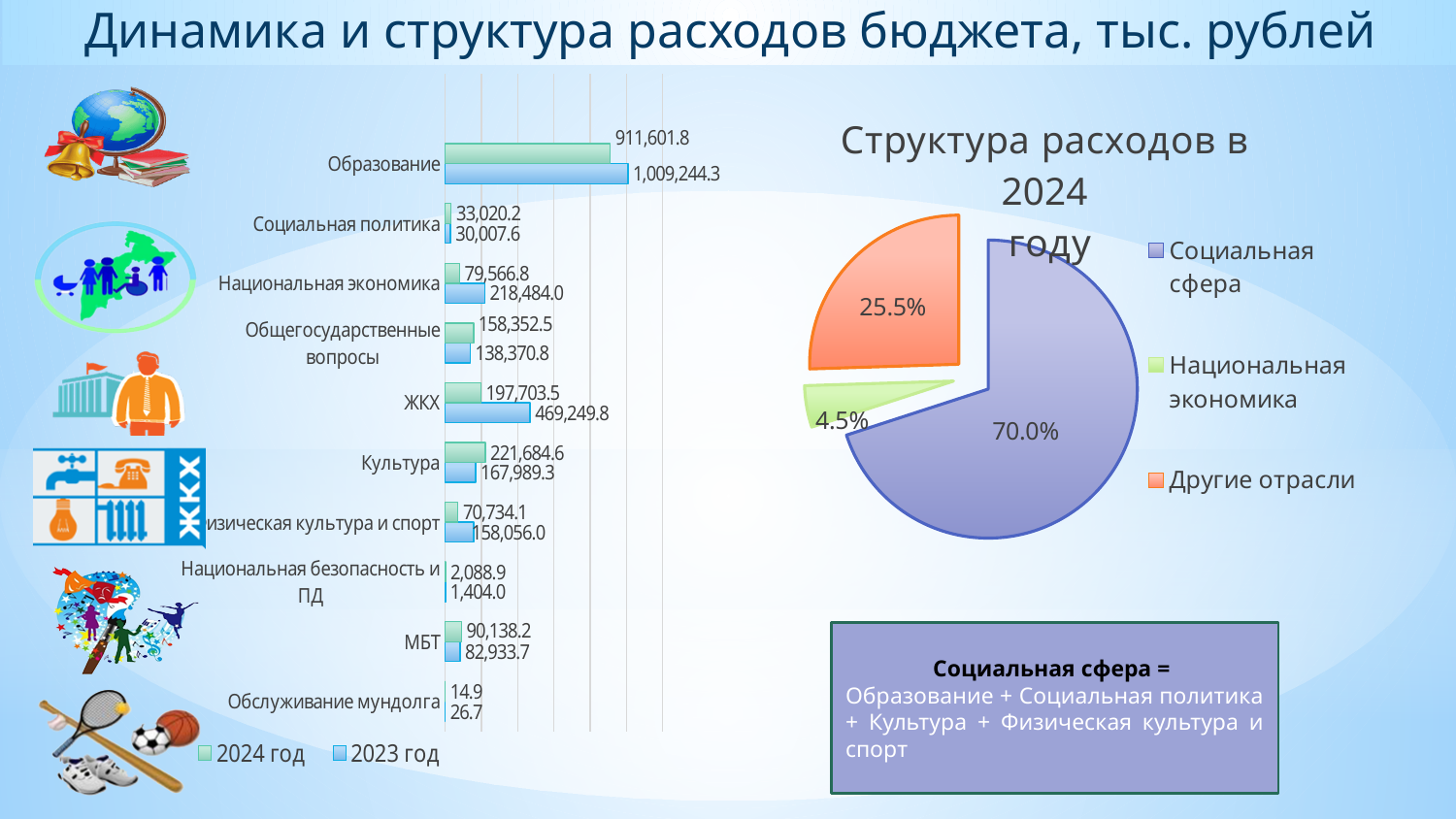
What type of chart is the chart on the left of the slide? Bar chart On the bar chart on the left, what is the value for Образование in 2024 год? 911,601.8 On the bar chart on the left, what is the value for Культура in 2024 год? 221,684.6 On the bar chart on the left, what is the value for ЖКХ in 2023 год? 469,249.8 On the bar chart on the left, which category has the highest value in 2023 год? Образование On the bar chart on the left, which category has the lowest value in 2024 год? Обслуживание мундолга On the bar chart on the left, which is larger for Национальная экономика: the 2024 год value or the 2023 год value? 2023 год On the pie chart 'Структура расходов в 2024 году', which slice is the smallest? Национальная экономика On the bar chart on the left, what is the difference between the 2023 год and 2024 год values for Образование? 97,642.5 On the bar chart on the left, how many categories are shown? 10 On the pie chart 'Структура расходов в 2024 году', what share does Социальная сфера have? 70.0% On the bar chart on the left, how many series does the legend list? 2